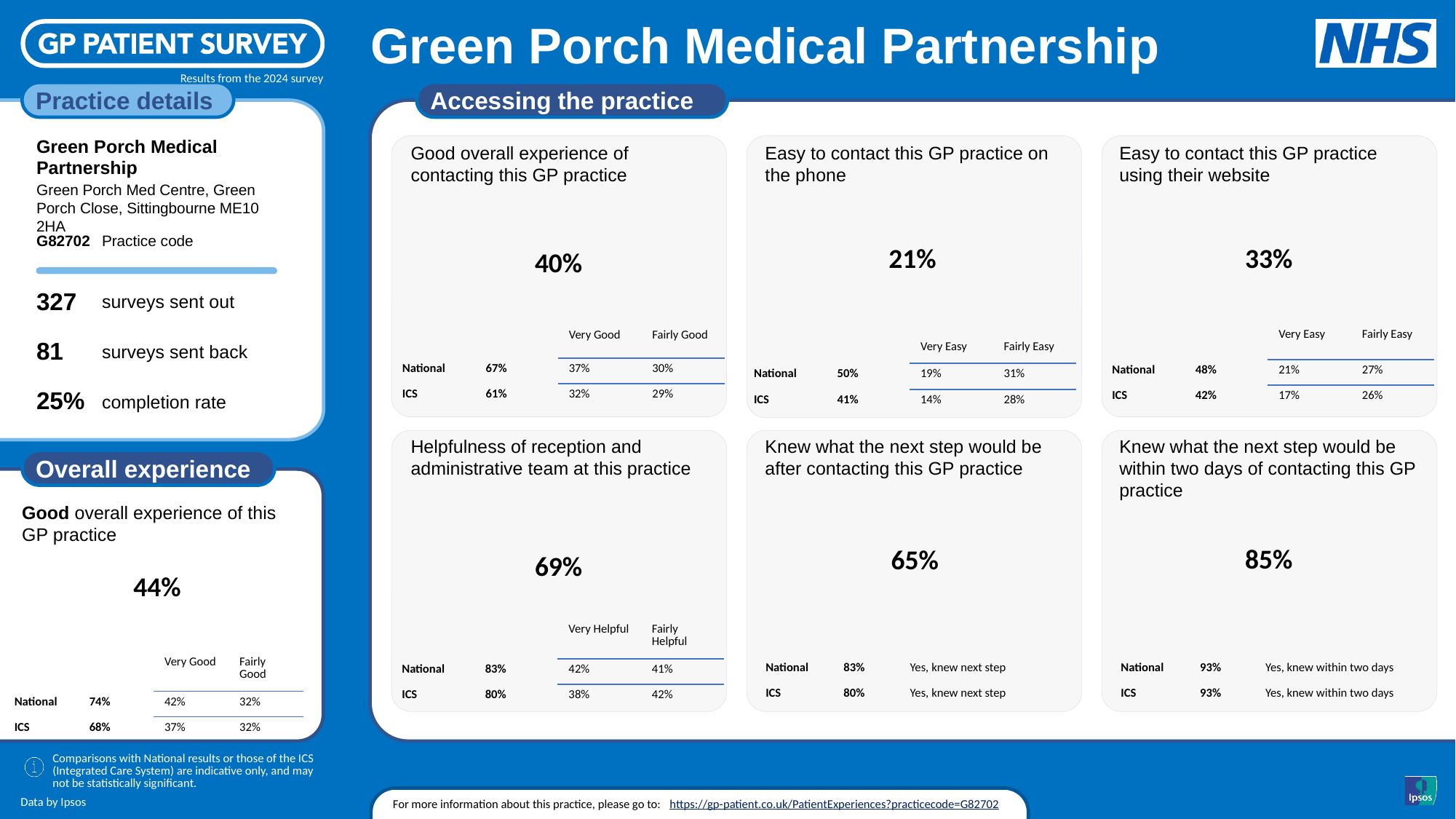
On the 'Knew what the next step would be within two days of contacting this GP practice' chart, are the National and ICS values the same? Yes, both 93% On the 'Easy to contact this GP practice using their website' chart, what is the National value? 48% Among the six charts in the Accessing the practice section, which has the highest practice headline percentage? Knew what the next step would be within two days of contacting this GP practice On the 'Good overall experience of contacting this GP practice' chart, what is the practice's headline percentage? 40% Among the six charts in the Accessing the practice section, which has the lowest practice headline percentage? Easy to contact this GP practice on the phone On the 'Knew what the next step would be within two days of contacting this GP practice' chart, what is the practice's headline percentage? 85% On the 'Good overall experience of this GP practice' chart in the Overall experience section, what is the National value for Fairly Good? 32% On the 'Knew what the next step would be after contacting this GP practice' chart, which is larger, the National value or the ICS value? National On the 'Helpfulness of reception and administrative team at this practice' chart, what is the ICS value for Very Helpful? 38% How many charts are shown in the Accessing the practice section? 6 On the 'Easy to contact this GP practice on the phone' chart, what is the practice's headline percentage? 21% On the 'Easy to contact this GP practice on the phone' chart, what is the difference between the National value (50%) and the ICS value (41%)? 9%